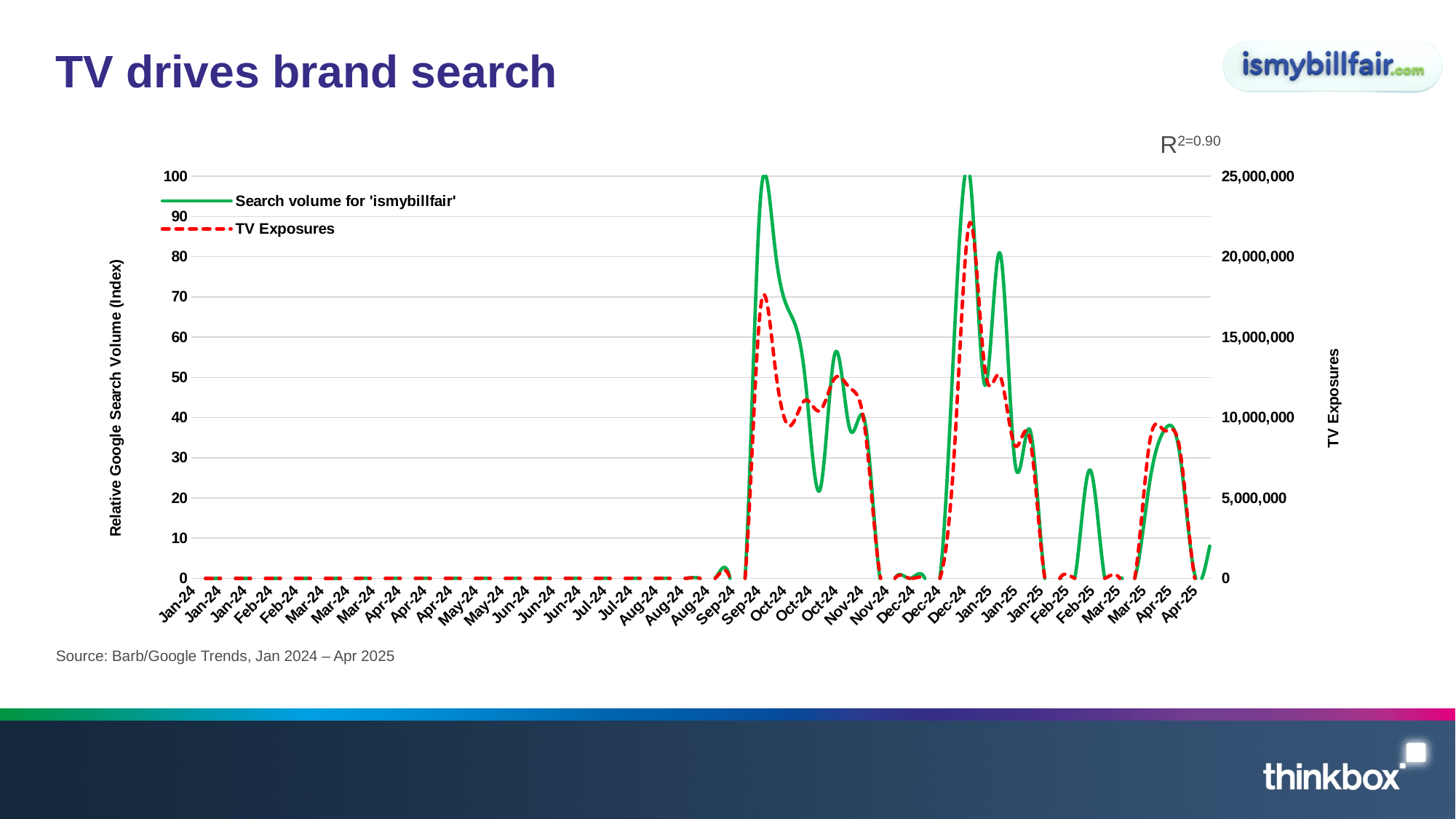
Between Jan-24 and Aug-24, does 'Search volume for ismybillfair' rise, fall, or stay flat? stay flat Is the peak value of 'TV Exposures' in Dec-24 greater or less than 20,000,000? greater Is the peak value of 'Search volume for ismybillfair' in Feb-25 greater or less than 20? greater Is the peak value of 'TV Exposures' in Apr-25 greater or less than 5,000,000? greater What kind of chart is shown on the slide? line chart Which is higher: the peak of 'Search volume for ismybillfair' in Dec-24 or its peak in Feb-25? Dec-24 How many series does the chart's legend list? 2 What R-squared value is shown above the chart? 0.90